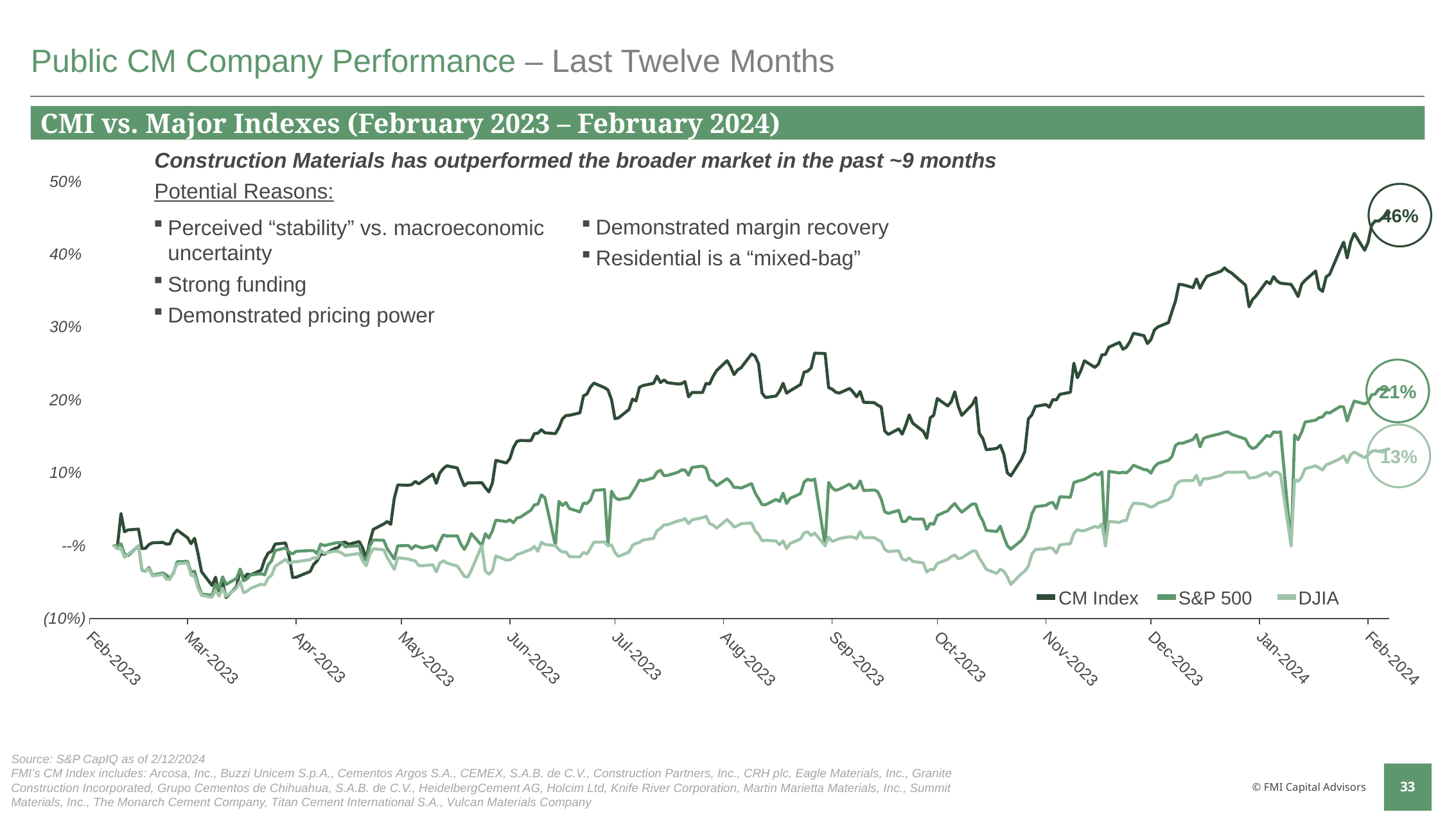
Is the value of the CM Index around Aug-2023 greater or less than 20%? greater What is the final labelled value for the DJIA at the right end of the chart? 13% What is the final labelled value for the S&P 500 at the right end of the chart? 21% Which ends higher in February 2024, the S&P 500 or the DJIA? S&P 500 What is the final labelled value for the CM Index at the right end of the chart? 46% Is the value of the DJIA around Jul-2023 greater or less than 10%? less How many series does the legend list? 3 Which series ends at the highest value in February 2024? CM Index Does the CM Index rise or fall between Nov-2023 and Feb-2024? Rise Which series ends at the lowest value in February 2024? DJIA What kind of chart is shown on the slide? Line chart By how many percentage points does the CM Index's final value exceed the S&P 500's final value? 25 percentage points